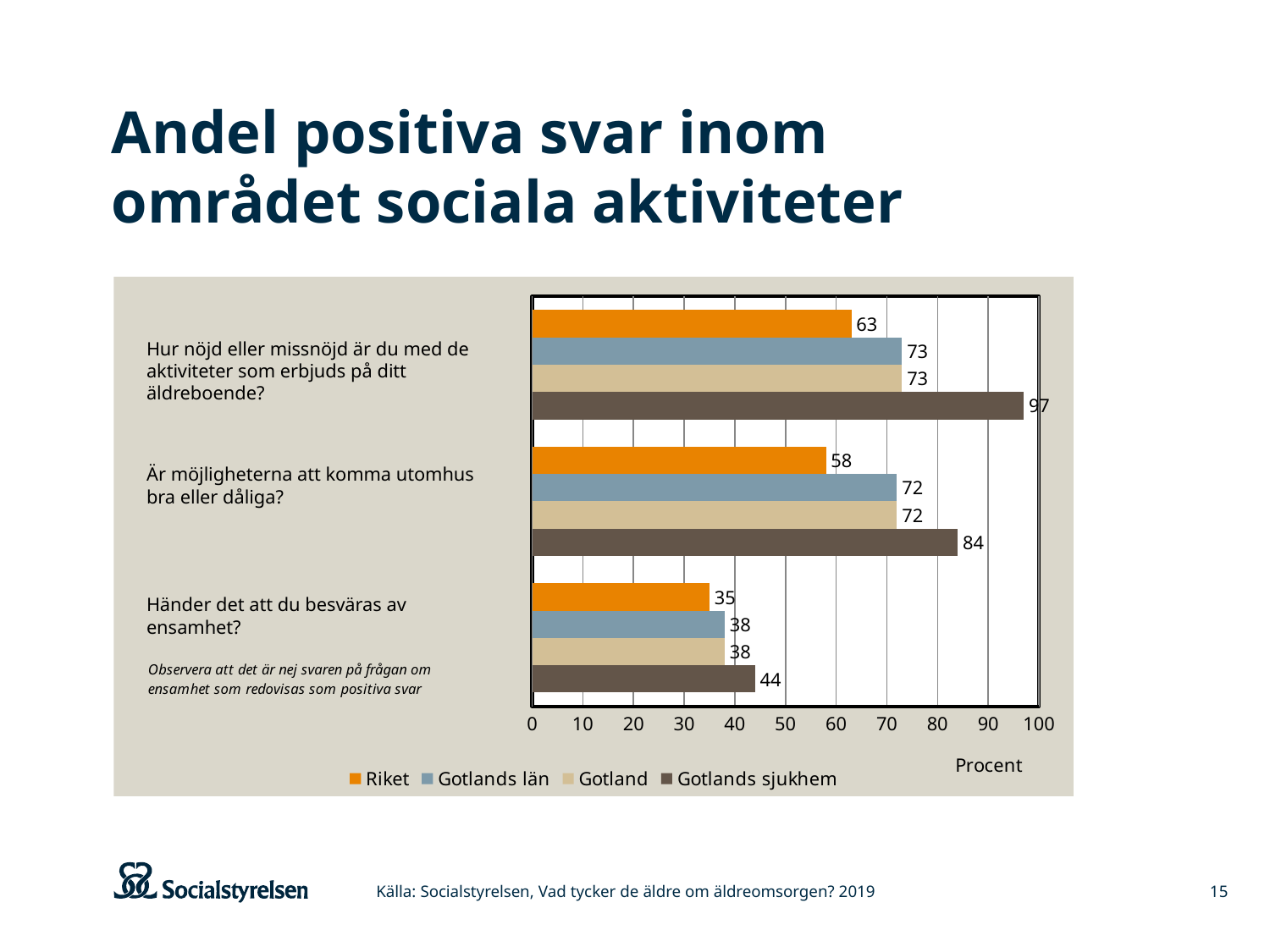
Which series has the highest value on the question 'Är möjligheterna att komma utomhus bra eller dåliga?'? Gotlands sjukhem What is the value for Riket on the question 'Är möjligheterna att komma utomhus bra eller dåliga?'? 58 Which series has the lowest value on the question 'Händer det att du besväras av ensamhet?'? Riket What is the value for Gotland on the question 'Händer det att du besväras av ensamhet?'? 38 What kind of chart is shown on the slide? Bar chart Which series is shown in orange in the legend? Riket How many series does the legend list? 4 What is the value for Gotlands sjukhem on the question 'Hur nöjd eller missnöjd är du med de aktiviteter som erbjuds på ditt äldreboende?'? 97 Which is larger: the Gotlands län value for 'Är möjligheterna att komma utomhus bra eller dåliga?' or the Gotlands län value for 'Händer det att du besväras av ensamhet?'? Är möjligheterna att komma utomhus bra eller dåliga? How many questions (categories) are shown on the chart? 3 What is the difference between Gotlands sjukhem and Riket on the question 'Hur nöjd eller missnöjd är du med de aktiviteter som erbjuds på ditt äldreboende?'? 34 What unit is shown on the horizontal axis of the chart? Procent